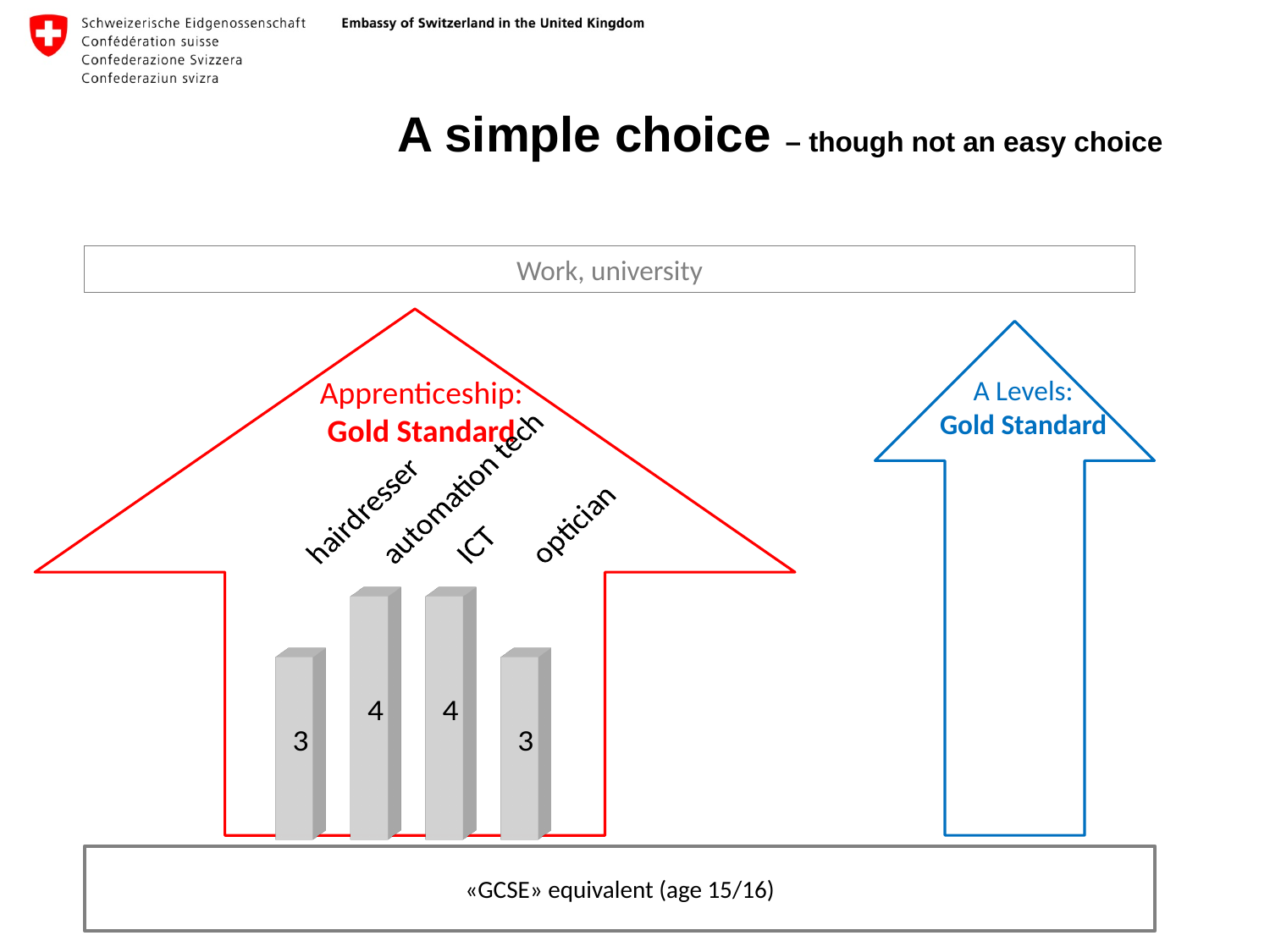
Which is larger, the value for automation tech or the value for optician? automation tech How many bars are plotted in the chart? 4 What is the difference between the value for automation tech and the value for optician? 1 Do the bar values rise or fall from hairdresser to automation tech? rise What value is shown on the bar for optician? 3 What value is shown on the bar for hairdresser? 3 Which is larger, the value for hairdresser or the value for ICT? ICT What value is shown on the bar for ICT? 4 What value is shown on the bar for automation tech? 4 What kind of chart is shown inside the red arrow? bar chart What colour are the bars in the chart? grey What is the difference between the value for ICT and the value for hairdresser? 1